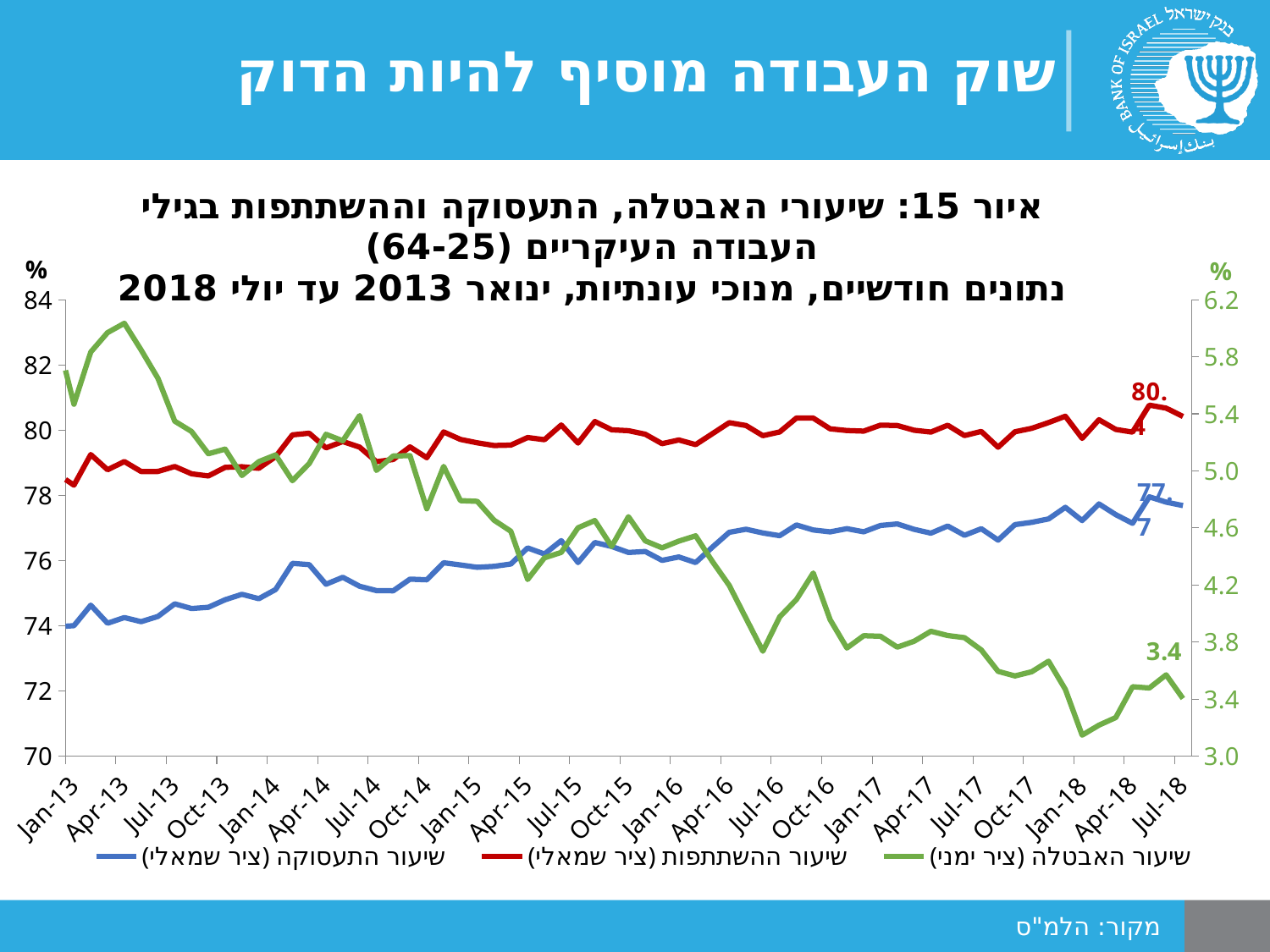
Is the participation rate (שיעור ההשתתפות) in Jan-13 greater or less than 80? less Is the employment rate (שיעור התעסוקה) in Jan-13 greater or less than 76? less Is the unemployment rate (שיעור האבטלה) in Apr-13 greater or less than 5.8 on the right axis? greater What value is labelled at the end of the unemployment rate (שיעור האבטלה) line in Jul-18? 3.4 How many series does the legend list? 3 What source is cited at the bottom of the slide? הלמ"ס In Jan-13, which is higher on the left axis: the participation rate or the employment rate? the participation rate What kind of chart is shown on the slide? line chart Does the employment rate (שיעור התעסוקה) line generally rise or fall from Jan-13 to Jul-18? rise Which series is plotted on the right axis (ציר ימני) according to the legend? שיעור האבטלה Does the unemployment rate (שיעור האבטלה) line generally rise or fall from Jan-13 to Jul-18? fall